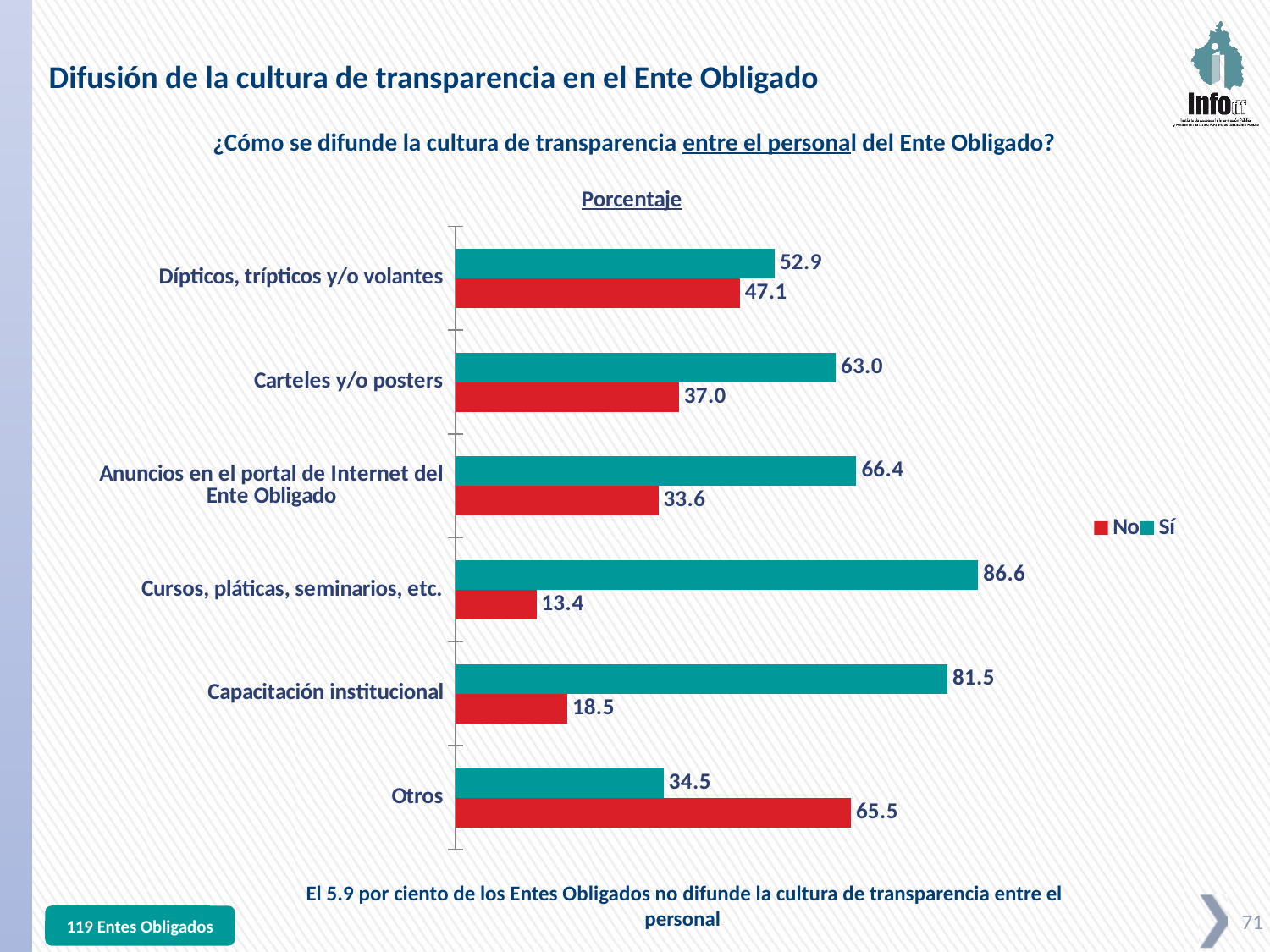
What is the 'No' value for 'Carteles y/o posters'? 37.0 How many series does the legend list? 2 What is the 'Sí' value for 'Cursos, pláticas, seminarios, etc.'? 86.6 Which is larger for 'Dípticos, trípticos y/o volantes': the 'Sí' value or the 'No' value? Sí Which category has the lowest 'No' value? Cursos, pláticas, seminarios, etc. What is the difference between the 'Sí' and 'No' values for 'Capacitación institucional'? 63.0 What is the 'Sí' value for 'Otros'? 34.5 What is the 'No' value for 'Anuncios en el portal de Internet del Ente Obligado'? 33.6 Which category has the highest 'Sí' value? Cursos, pláticas, seminarios, etc. Which colour represents the 'No' series in the legend? Red How many categories are shown on the chart? 6 What kind of chart is shown on the slide? Bar chart